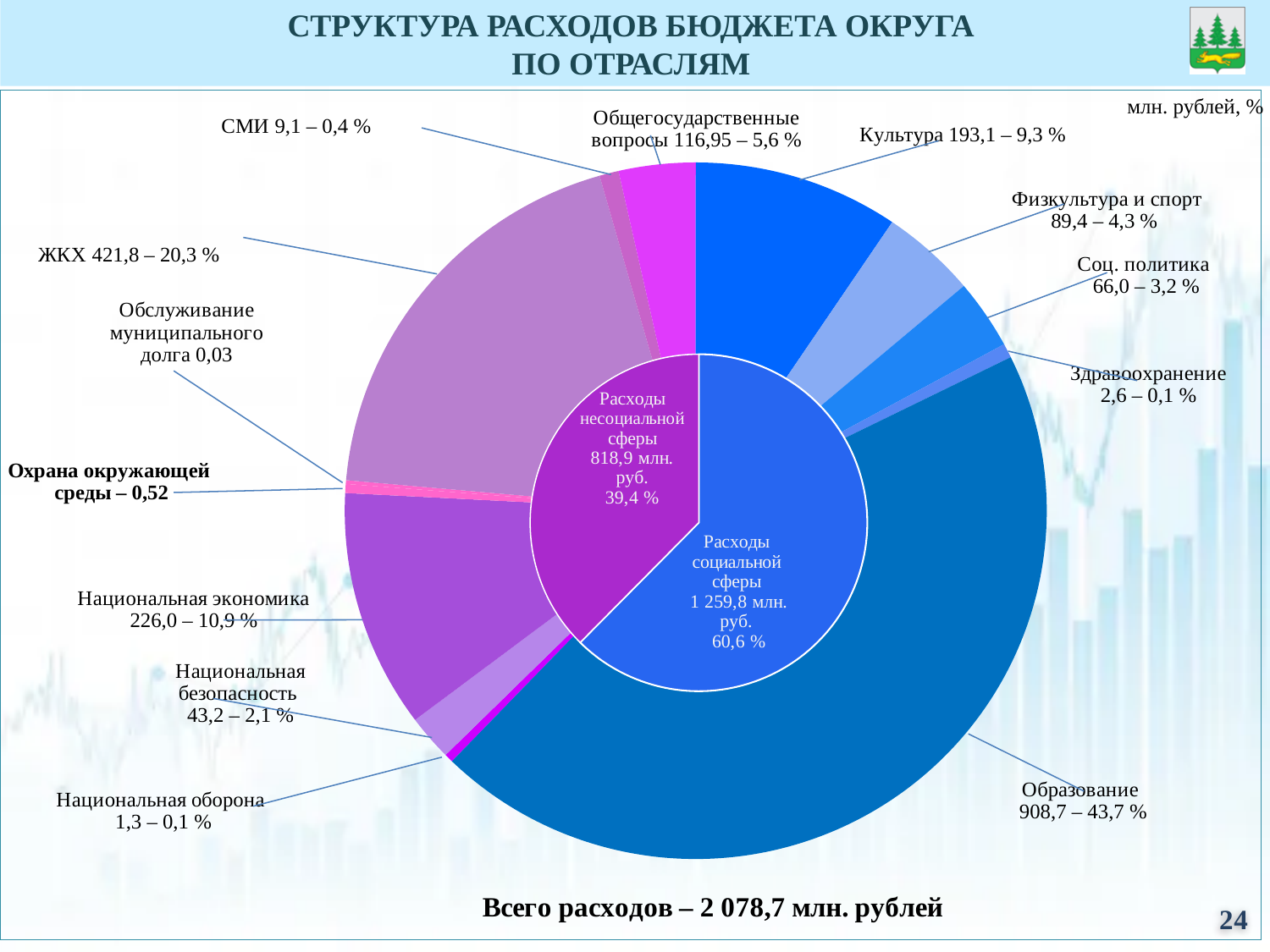
What is the value for Образование in млн. рублей? 908,7 What type of chart is shown on the slide? Pie chart What is the value for Культура in млн. рублей? 193,1 How many sectors are labelled in the outer ring of the pie chart? 13 What is the total of all expenditures shown on the slide? 2 078,7 млн. рублей Which sector has the smallest value in млн. рублей? Обслуживание муниципального долга What share of expenditures does ЖКХ account for? 20,3 % What share of expenditures is Расходы социальной сферы in the inner pie? 60,6 % What is the value for Расходы несоциальной сферы in the inner pie? 818,9 млн. руб. Which sector has the largest share of expenditures? Образование Which is larger: the value for Физкультура и спорт or the value for Соц. политика? Физкультура и спорт What is the difference in млн. рублей between Национальная экономика and Культура? 32,9